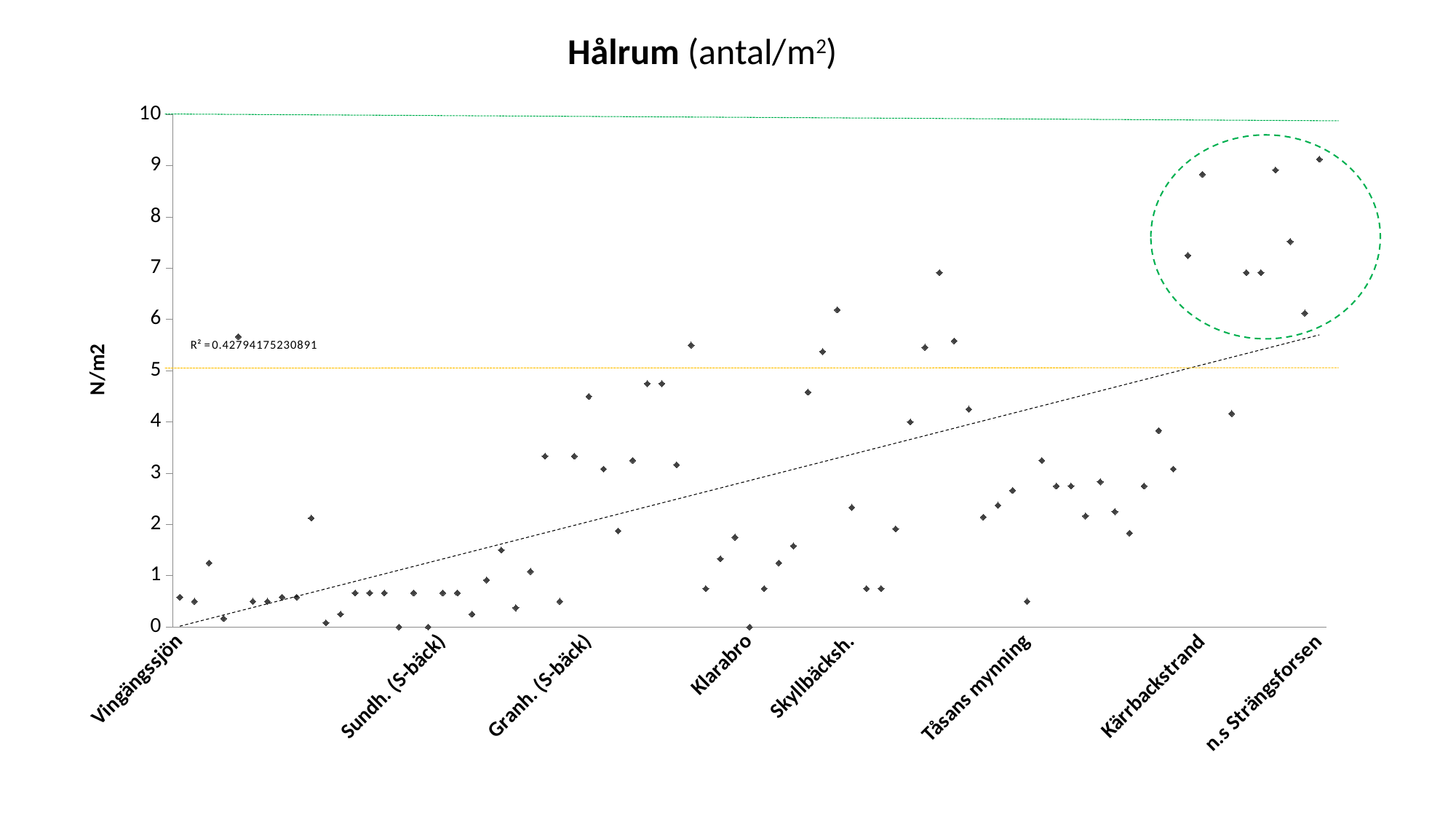
What is the title of the chart? Hålrum (antal/m²) What kind of chart is shown on the slide? scatter chart What is the label on the vertical axis of the chart? N/m2 Is the highest point plotted near Skyllbäcksh. greater or less than 5? greater Are the points inside the green dashed circle greater or less than 5? greater What is the highest value shown on the vertical axis? 10 Which site is labelled first (leftmost) on the x axis? Vingängssjön How many site names are labelled along the x axis? 8 Do the values generally rise or fall from left to right along the x axis, according to the dashed trend line? rise Which site is labelled last (rightmost) on the x axis? n.s Strängsforsen What R² value is printed on the chart? R² = 0.42794175230891